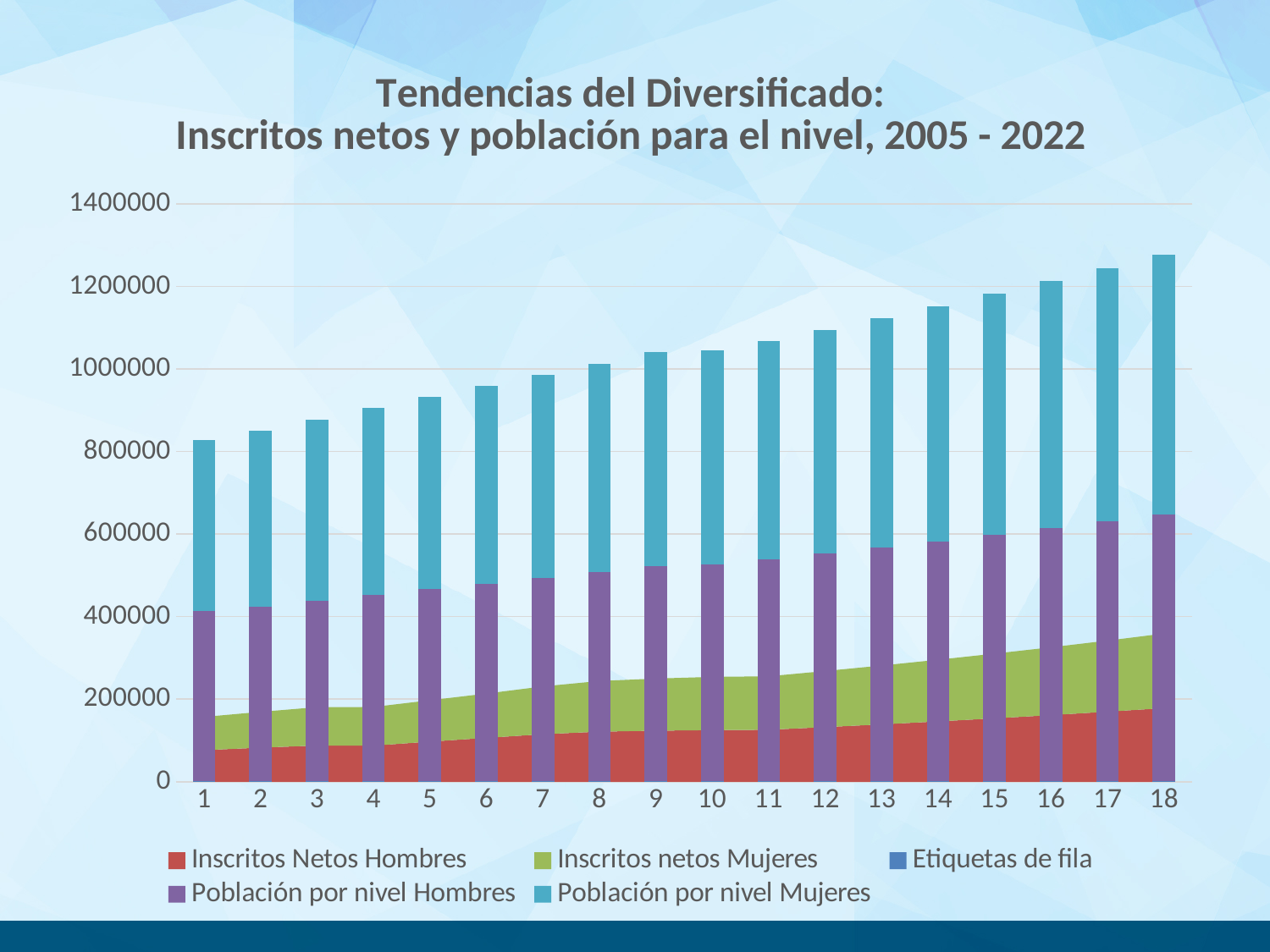
Do the total heights of the stacked bars rise or fall from category 1 to category 18? rise Which stacked bar is taller, category 1 or category 18? 18 How many series does the legend list? 5 Is the total height of the stacked bar for category 1 greater or less than 1000000? less Which category has the tallest stacked bar? 18 How many categories are shown along the x axis? 18 Which category has the shortest stacked bar? 1 What is the title of the chart? Tendencias del Diversificado: Inscritos netos y población para el nivel, 2005 - 2022 What kind of chart is this? combination area and bar chart Is the total height of the stacked bar for category 18 greater or less than 1200000? greater Is the total height of the stacked bar for category 12 greater or less than 1000000? greater Which colour represents Población por nivel Mujeres in the legend? light blue (teal)